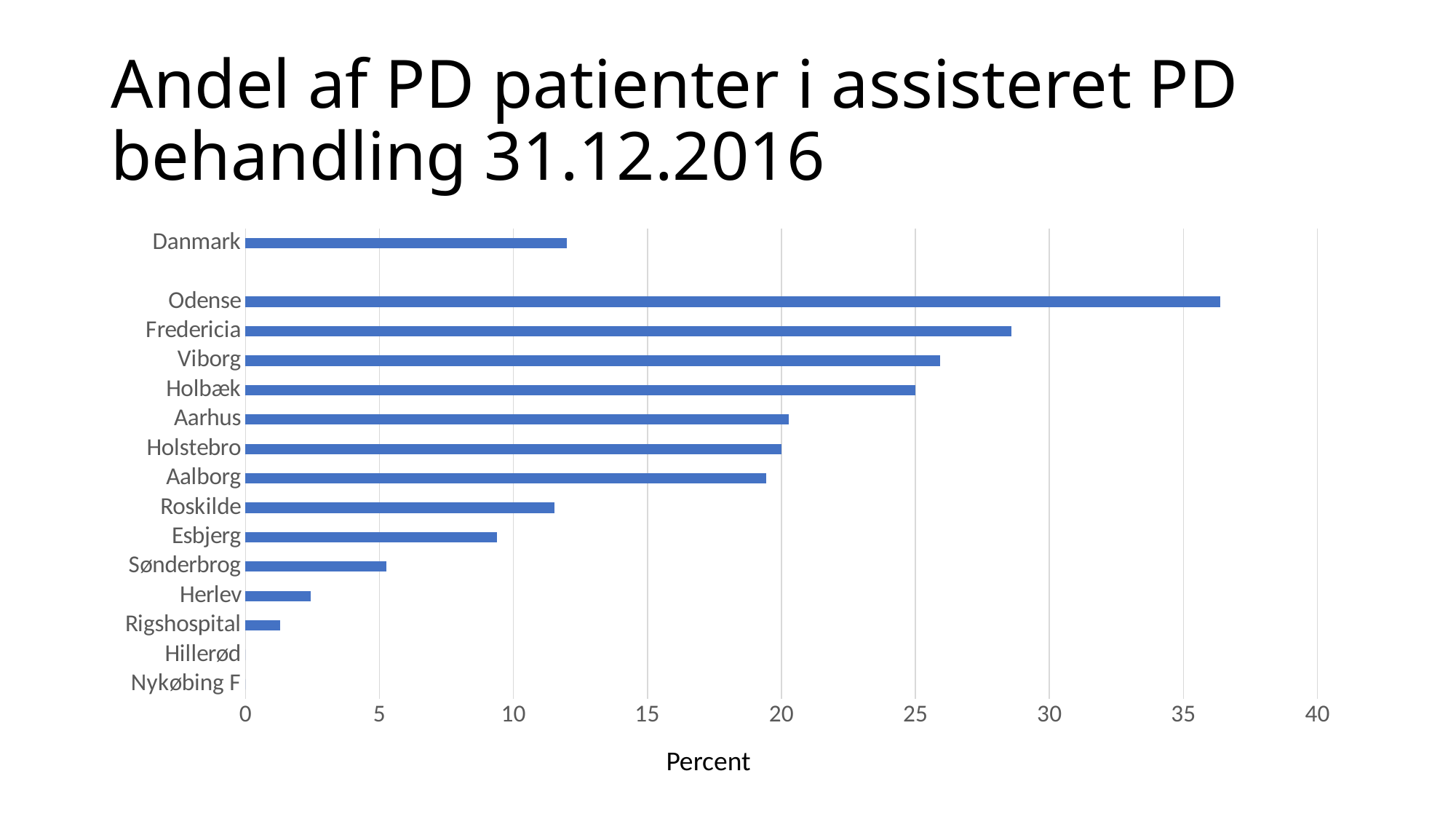
What kind of chart is shown on the slide? bar chart What is the title of the chart on the slide? Andel af PD patienter i assisteret PD behandling 31.12.2016 Is the value for Aalborg greater or less than 20? less Which is larger, the value for Fredericia or the value for Viborg? Fredericia Which is larger, the value for Roskilde or the value for Esbjerg? Roskilde Is the value for Fredericia greater or less than 30? less Is the value for Danmark greater or less than 10? greater What is the title of the horizontal axis? Percent Which category has the highest value? Odense